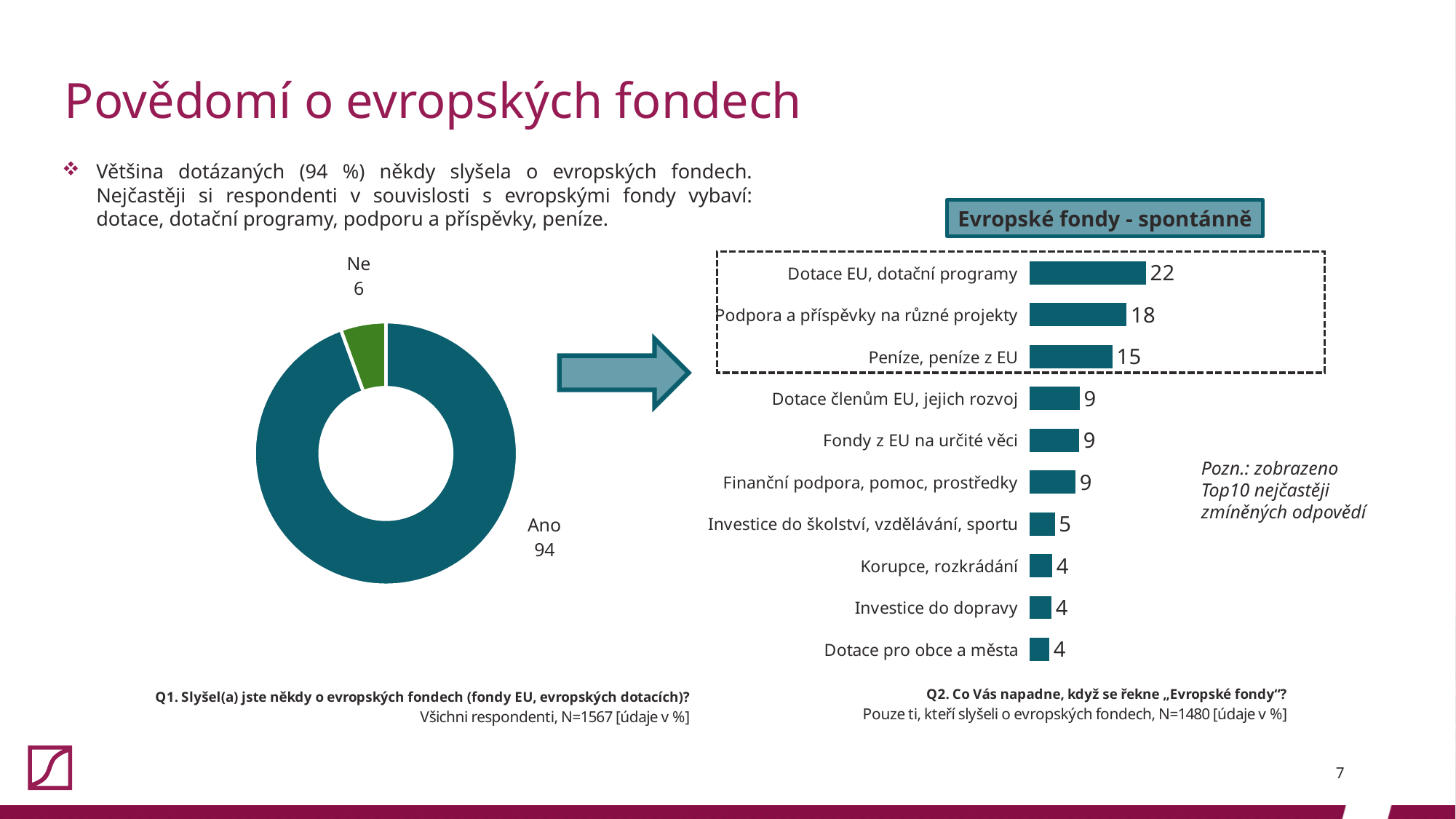
What kind of chart is the chart on the left of the slide? Donut (pie) chart In the "Evropské fondy - spontánně" chart, what is the value for "Investice do dopravy"? 4 In the "Evropské fondy - spontánně" chart, what is the value for "Dotace EU, dotační programy"? 22 In the donut chart on the left, what is the difference between the values for "Ano" and "Ne"? 88 In the "Evropské fondy - spontánně" chart, which category has the highest value? Dotace EU, dotační programy In the "Evropské fondy - spontánně" chart, how many categories are shown? 10 In the "Evropské fondy - spontánně" chart, which is larger: "Dotace členům EU, jejich rozvoj" or "Korupce, rozkrádání"? Dotace členům EU, jejich rozvoj What kind of chart is the "Evropské fondy - spontánně" chart? Bar chart In the donut chart on the left, what is the value for "Ano"? 94 In the "Evropské fondy - spontánně" chart, what is the difference between "Podpora a příspěvky na různé projekty" and "Investice do školství, vzdělávání, sportu"? 13 In the "Evropské fondy - spontánně" chart, what is the value for "Peníze, peníze z EU"? 15 In the donut chart on the left, what is the value for "Ne"? 6